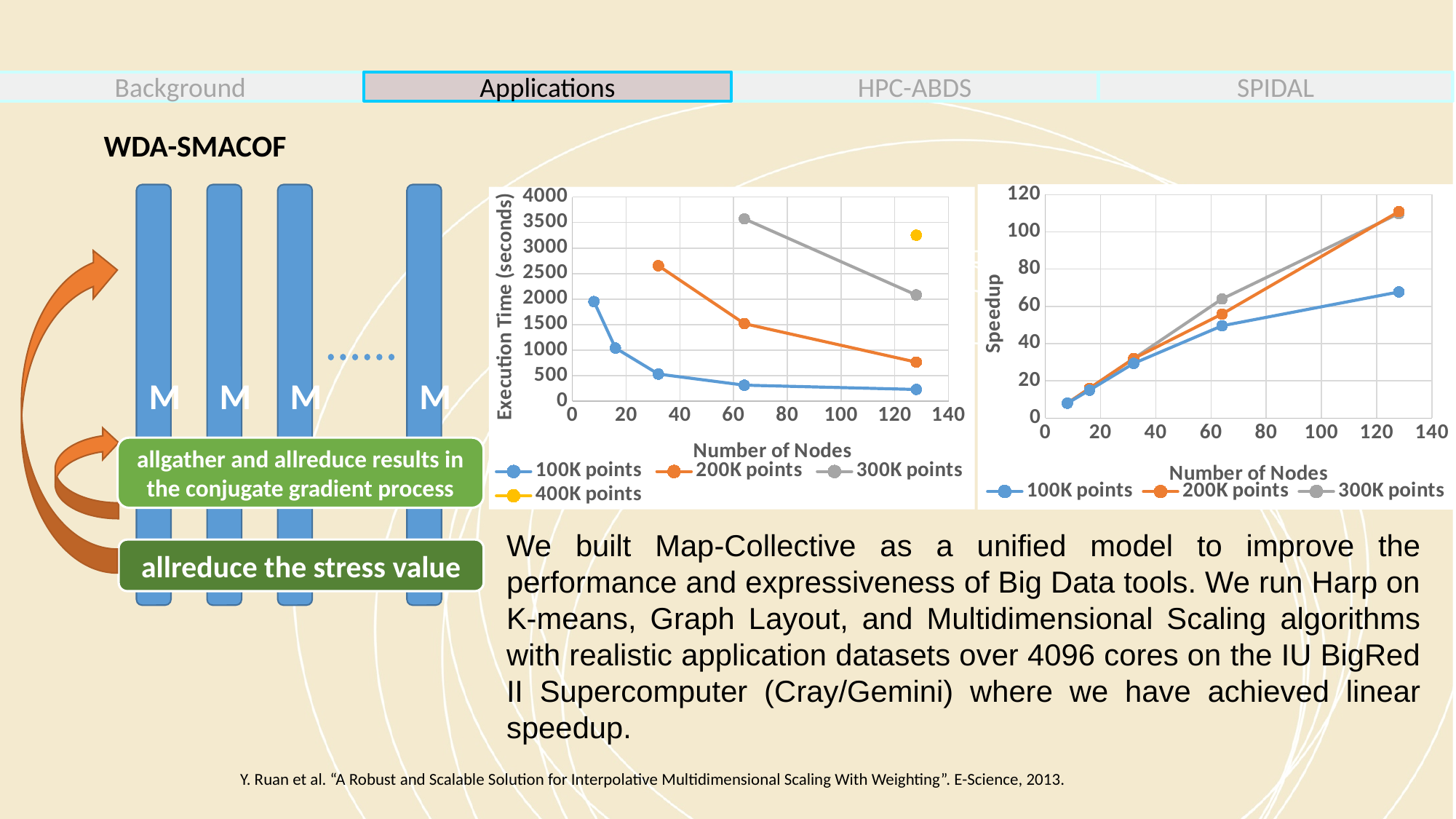
How many series does the legend of the left Execution Time chart list? 4 How many series does the legend of the right Speedup chart list? 3 In the left Execution Time chart, is the value for 100K points at 128 nodes greater or less than 500? less What is the y-axis title of the left chart? Execution Time (seconds) In the left Execution Time chart, does the 100K points series rise or fall as the number of nodes increases? fall In the right Speedup chart, does the 100K points series rise or fall as the number of nodes increases? rise In the left Execution Time chart, is the value for 300K points at 64 nodes greater or less than 3000? greater In the left Execution Time chart, how many data points are plotted for the 100K points series? 5 What kind of chart is the left chart showing Execution Time (seconds) against Number of Nodes? line chart In the right Speedup chart, at 64 nodes, which series has the higher speedup: 300K points or 100K points? 300K points In the right Speedup chart, is the value for 200K points at 128 nodes greater or less than 100? greater In the left Execution Time chart, at 128 nodes, which has the higher execution time: 400K points or 300K points? 400K points